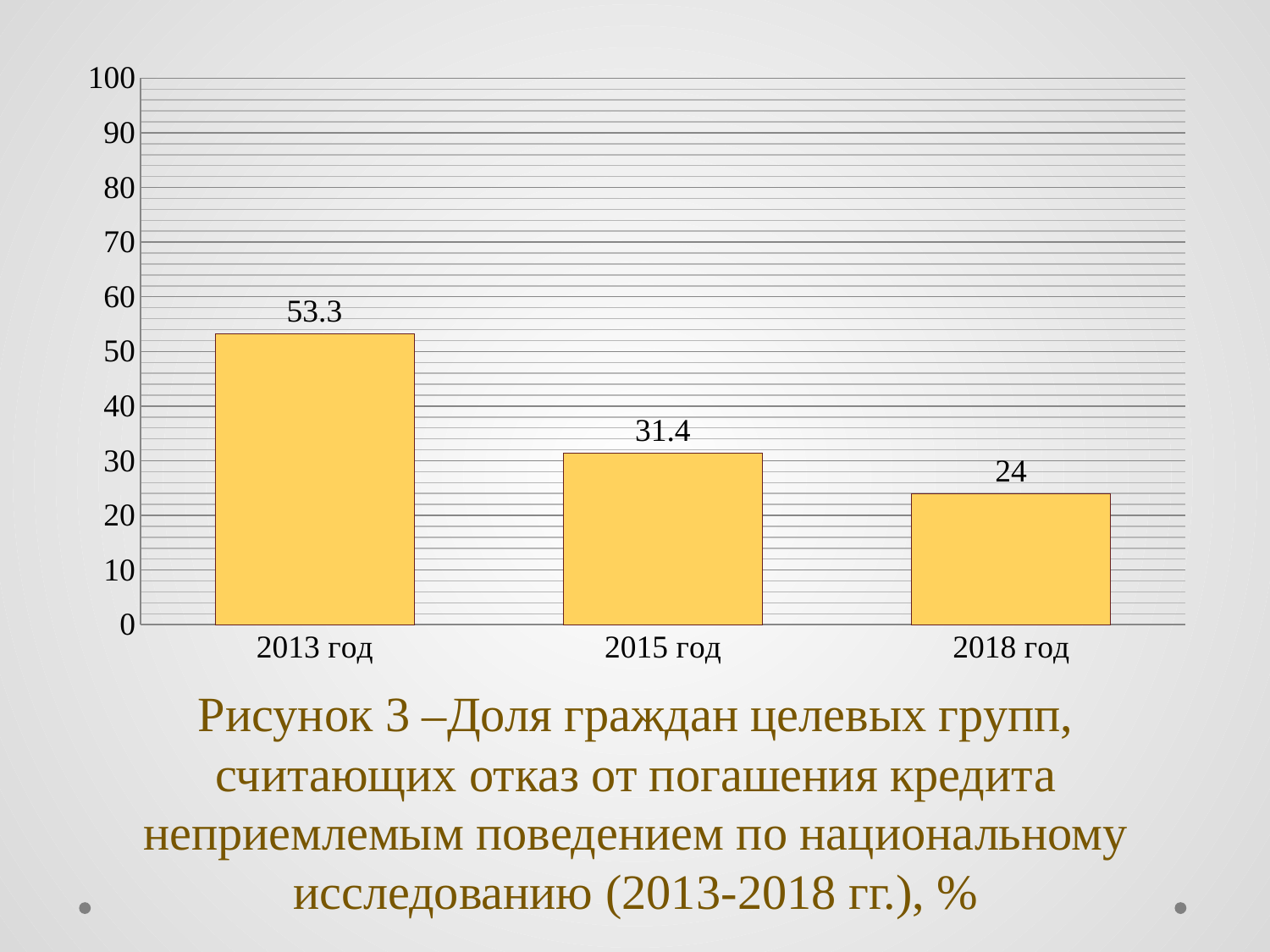
What is the value for 2015 год? 31.4 What is the value for 2013 год? 53.3 What is the difference between the values for 2015 год and 2018 год? 7.4 What is the difference between the values for 2013 год and 2015 год? 21.9 Which is larger, the value for 2015 год or the value for 2018 год? 2015 год Which year has the highest value? 2013 год Is the value for 2013 год greater or less than 50? greater How many categories are shown on the x axis? 3 What is the value for 2018 год? 24 Do the values rise or fall from 2013 год to 2018 год? fall What kind of chart is shown on the slide? bar chart Which year has the lowest value? 2018 год